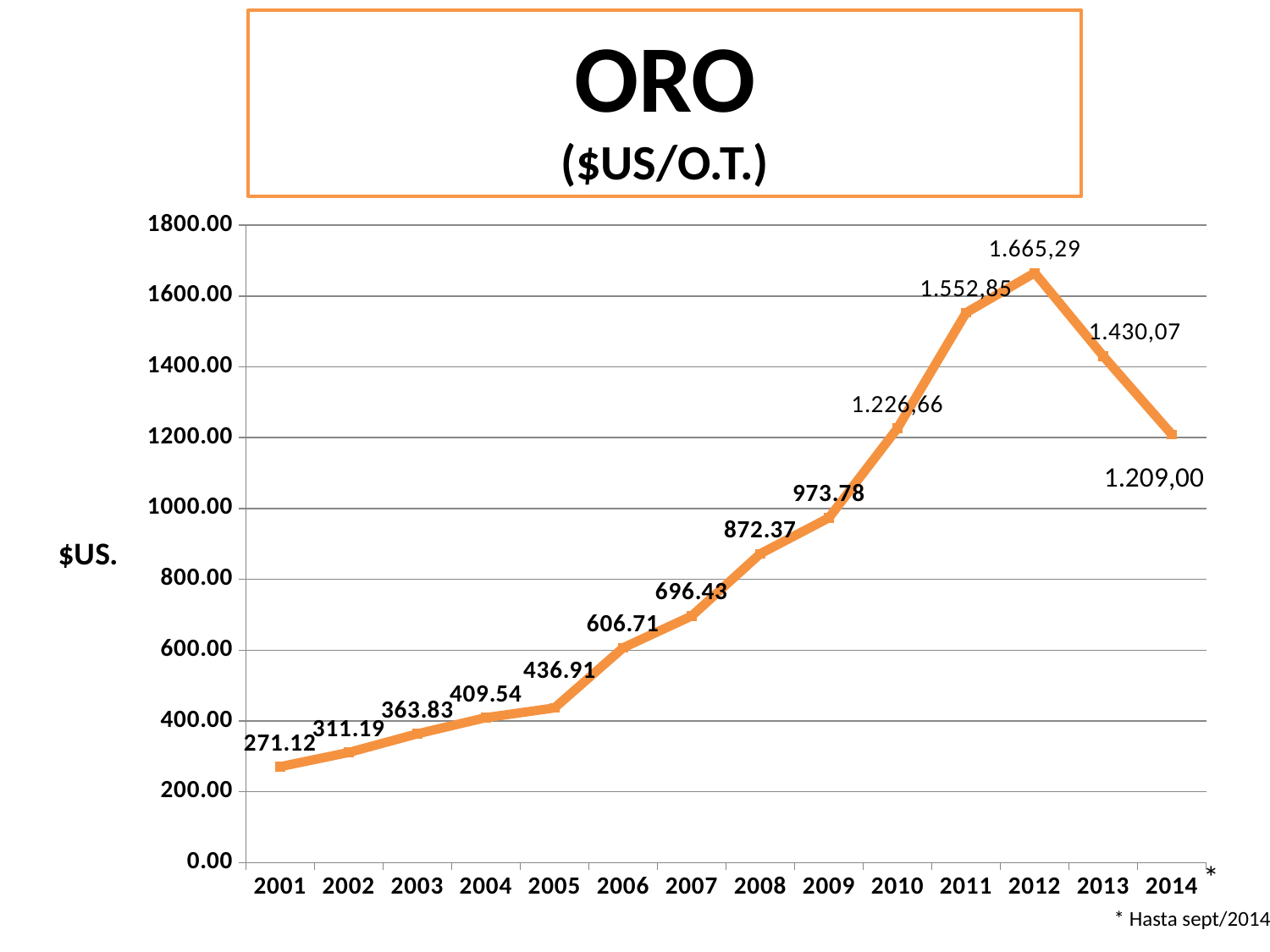
What is the value for 2014? 1.209,00 What is the difference between the values for 2002 and 2001? 40.07 What is the value for 2012? 1.665,29 Is the value for 2013 greater or less than 1400? greater Which is larger, the value for 2013 or the value for 2014? 2013 Which year has the highest value? 2012 Which year has the lowest value? 2001 What is the title of the chart? ORO ($US/O.T.) What is the value for 2008? 872.37 What is the value for 2001? 271.12 What kind of chart is shown on the slide? line chart How many years are plotted on the chart? 14